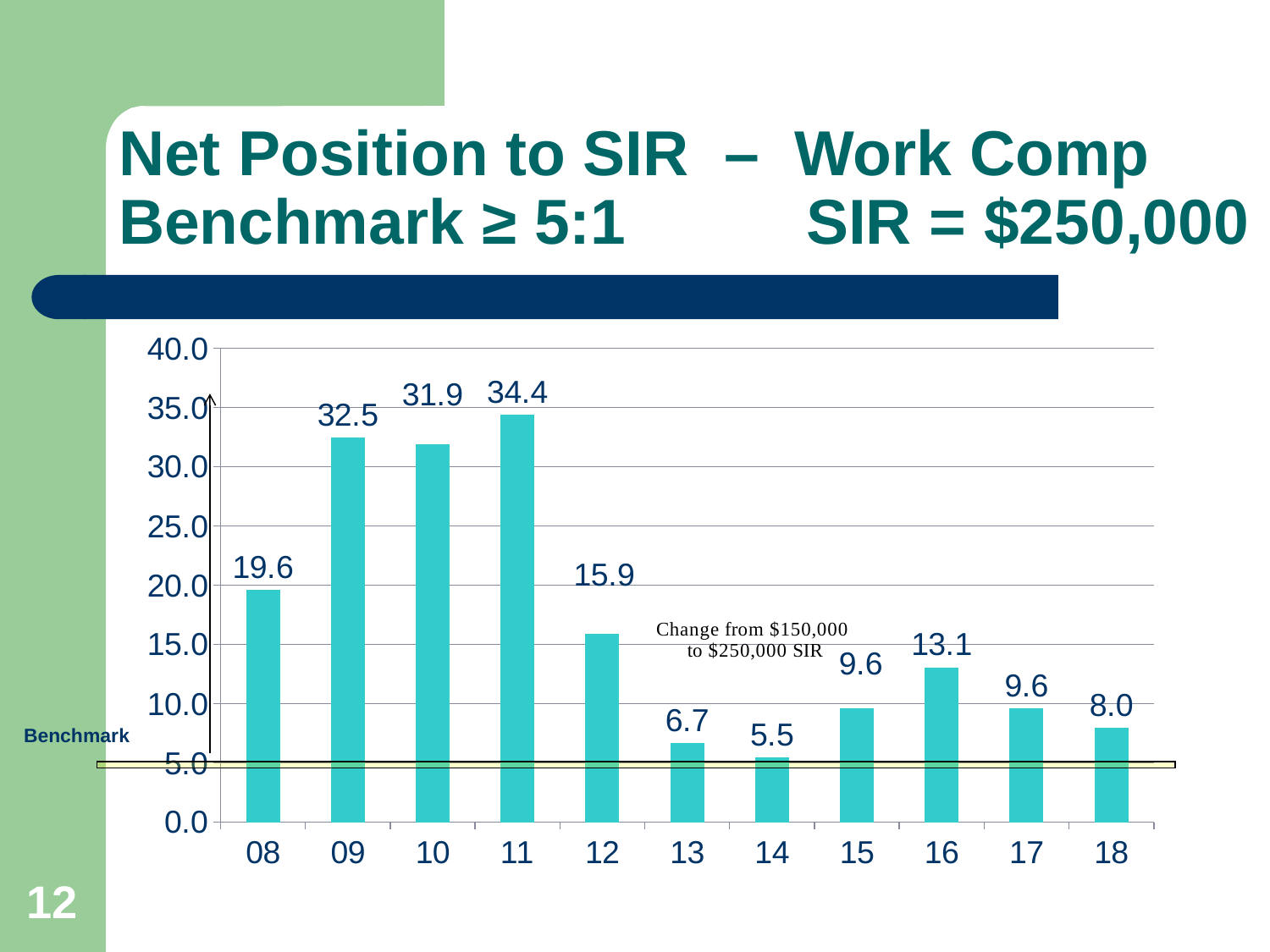
What kind of chart is shown? bar chart How many years are shown on the x axis? 11 Do the values generally rise or fall from 11 to 14? fall Which is larger, the value for 09 or the value for 10? 09 What is the value for 11? 34.4 What is the value for 08? 19.6 What is the value for 14? 5.5 Is the value for 16 greater or less than 10.0? greater What value does the Benchmark line mark on the y axis? 5.0 Which year has the highest value? 11 What is the difference between the values for 11 and 12? 18.5 Which year has the lowest value? 14